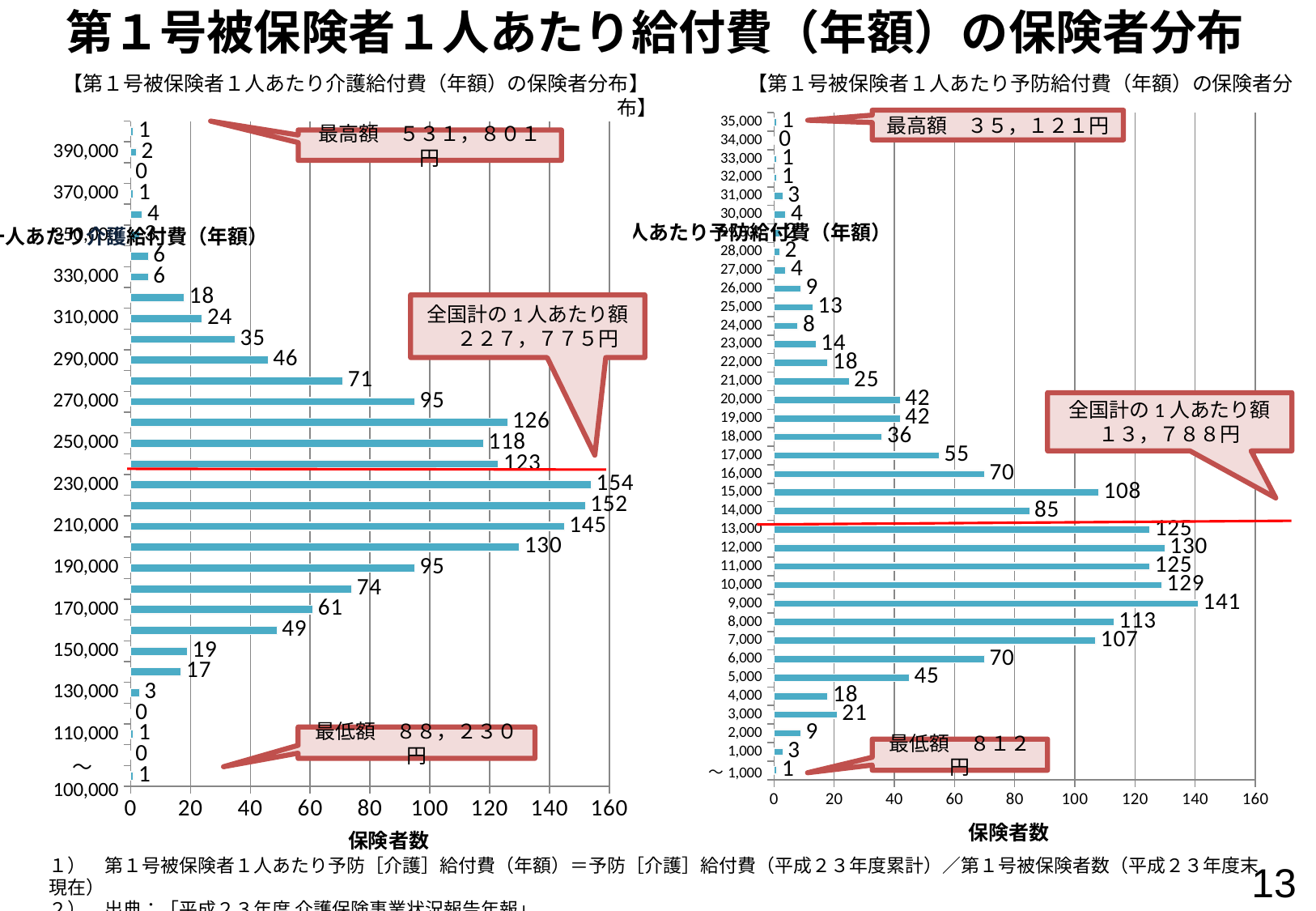
In the left chart (介護給付費), which category has the highest number of insurers? 230,000 In the left chart (介護給付費), what is the number of insurers (保険者数) for the 230,000 category? 154 In the right chart (予防給付費), what is the value for the 9,000 category? 141 According to the callout on the left chart (介護給付費), what is the national per-person amount (全国計の1人あたり額)? 227,775円 What type of chart is used on this slide? Bar chart In the right chart (予防給付費), which category has the highest number of insurers? 9,000 In the left chart (介護給付費), what is the difference between the values for 230,000 and 210,000? 9 In the right chart (予防給付費), what is the number of insurers for the 15,000 category? 108 In the right chart (予防給付費), what is the difference between the values for 12,000 and 8,000? 17 In the right chart (予防給付費), which is larger, the value for 16,000 or the value for 5,000? 16,000 In the left chart (介護給付費), what is the value for the 290,000 category? 46 In the left chart (介護給付費), which is larger, the value for 270,000 or the value for 170,000? 270,000